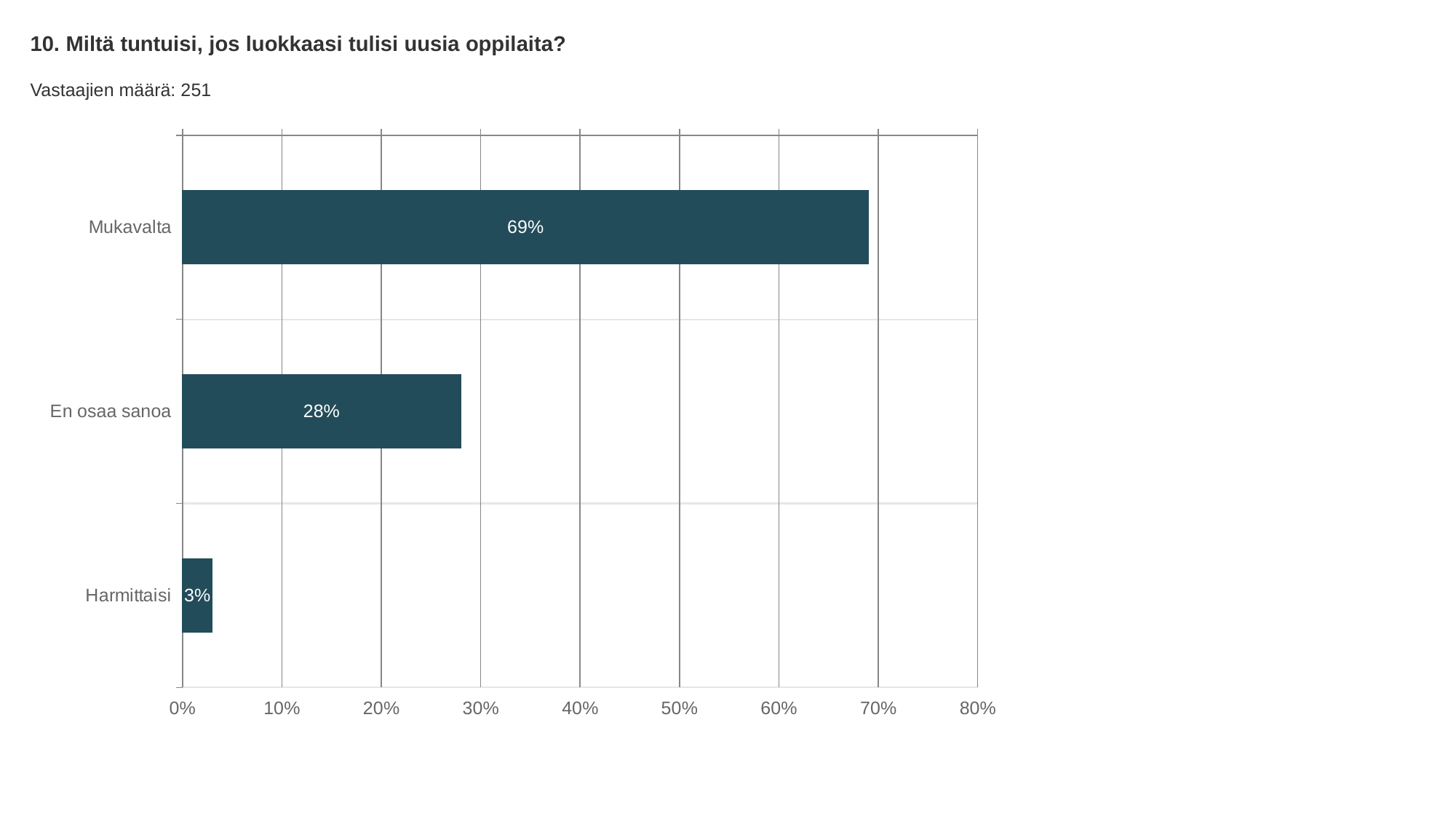
How many respondents (Vastaajien määrä) does the slide report? 251 What is the difference between the values for Mukavalta and En osaa sanoa? 41% What is the value for En osaa sanoa? 28% What is the value for Mukavalta? 69% Is the value for Mukavalta greater or less than 60%? greater How many categories are shown in the chart? 3 What is the difference between the values for En osaa sanoa and Harmittaisi? 25% What is the value for Harmittaisi? 3% Which category has the lowest value? Harmittaisi Which category has the highest value? Mukavalta What kind of chart is shown on the slide? bar chart Which is larger, the value for En osaa sanoa or the value for Harmittaisi? En osaa sanoa